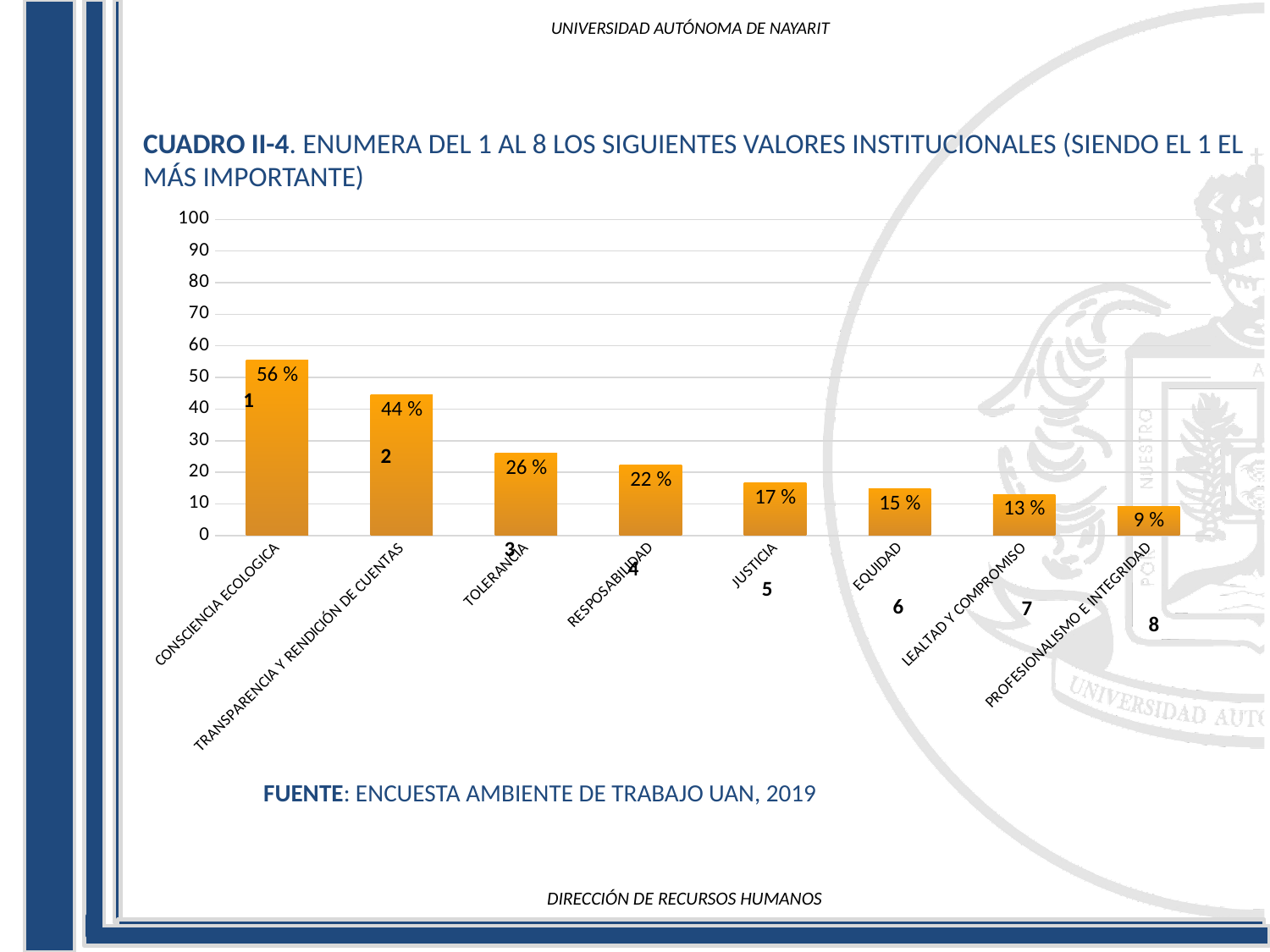
Which category has the lowest value? PROFESIONALISMO E INTEGRIDAD What kind of chart is shown on the slide? bar chart How many categories are shown in the chart? 8 What is the value for PROFESIONALISMO E INTEGRIDAD? 9 % Do the values rise or fall from left to right along the x axis? fall Which is larger, the value for TOLERANCIA or the value for EQUIDAD? TOLERANCIA What is the value for CONSCIENCIA ECOLOGICA? 56 % What is the difference between the values for CONSCIENCIA ECOLOGICA and TRANSPARENCIA Y RENDICIÓN DE CUENTAS? 12 % Is the value for RESPOSABILIDAD greater or less than 30? less What is the value for TRANSPARENCIA Y RENDICIÓN DE CUENTAS? 44 % Which category has the highest value? CONSCIENCIA ECOLOGICA What is the value for JUSTICIA? 17 %